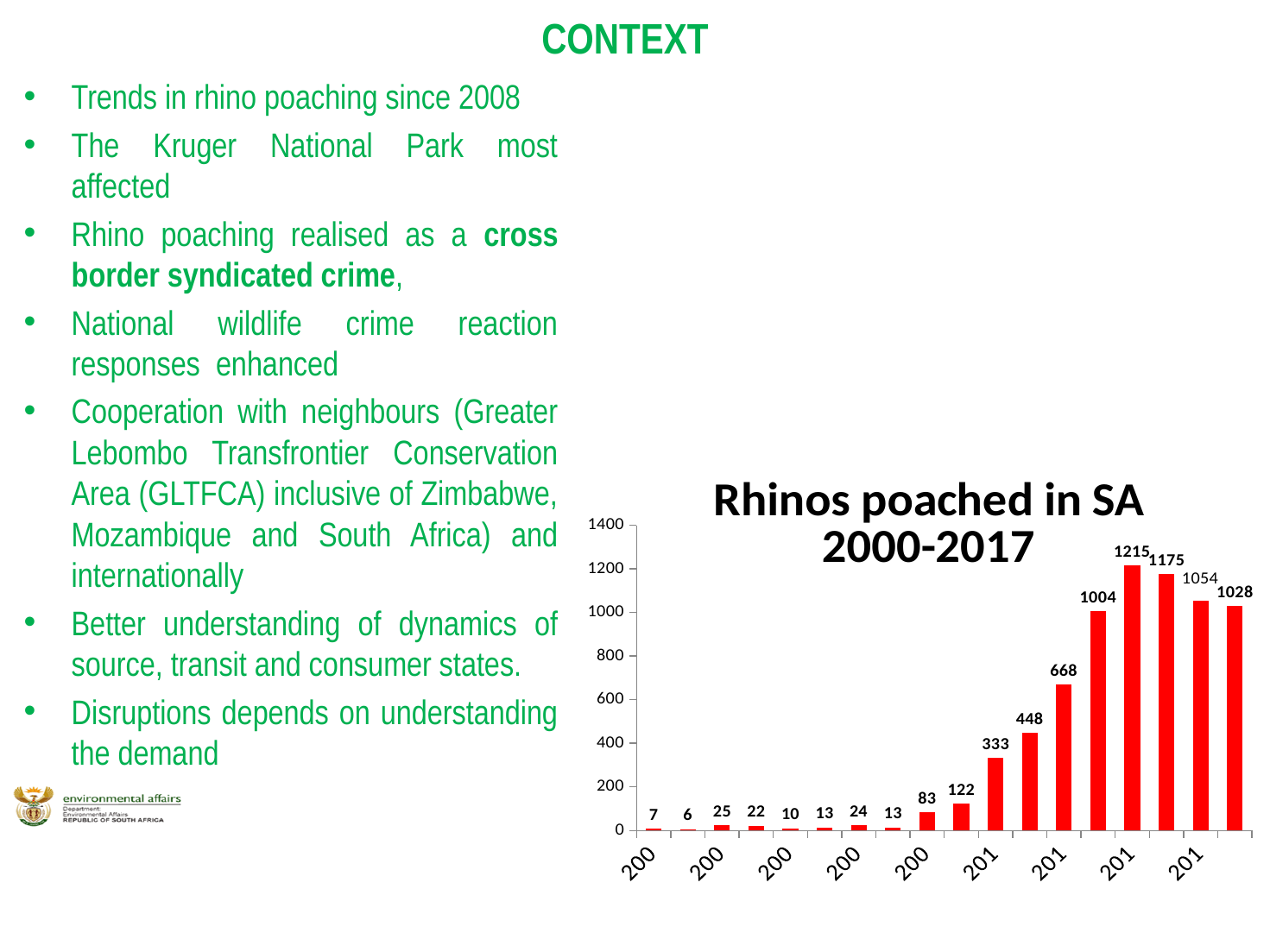
What is the title of the chart? Rhinos poached in SA 2000-2017 Which is larger, the bar labelled 1054 or the bar labelled 1028? 1054 What is the lowest value shown in the chart? 6 What is the value of the last bar (2017) in the chart? 1028 How many bars have values above 1000? 5 How many bars are plotted in the chart? 18 What is the value of the first bar (2000) in the chart? 7 What type of chart is shown on the slide? bar chart What is the difference between the two tallest bars, 1215 and 1175? 40 What is the difference between the bar labelled 1004 and the bar labelled 668? 336 Do the values generally rise or fall from the first bar to the tallest bar? rise What is the highest value shown in the chart? 1215